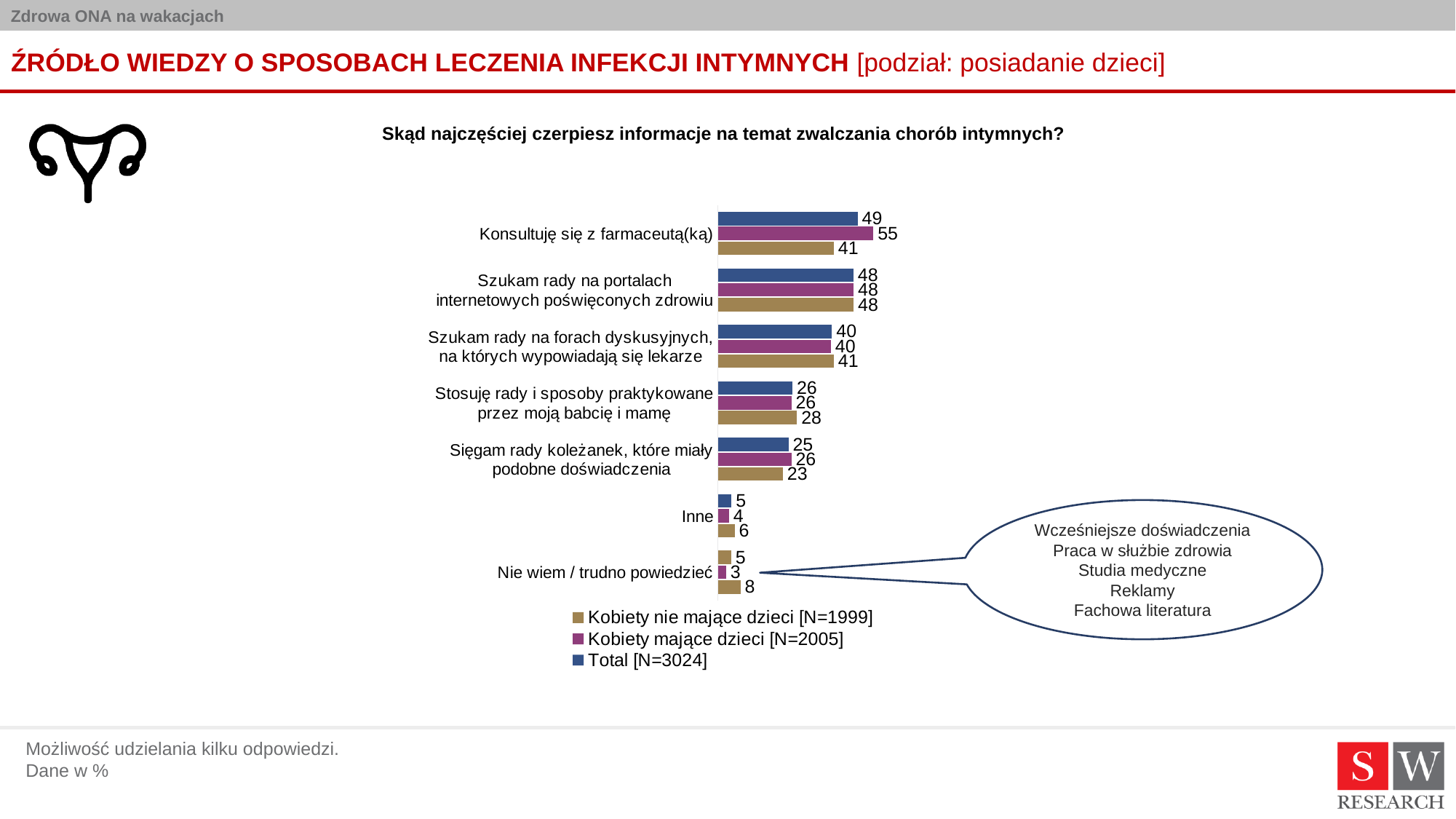
For "Stosuję rady i sposoby praktykowane przez moją babcię i mamę", which series has the larger value: "Kobiety nie mające dzieci [N=1999]" or "Total [N=3024]"? Kobiety nie mające dzieci [N=1999] Which category has the highest value in the "Kobiety mające dzieci [N=2005]" series? Konsultuję się z farmaceutą(ką) What is the difference between the "Kobiety mające dzieci [N=2005]" and "Kobiety nie mające dzieci [N=1999]" values for "Konsultuję się z farmaceutą(ką)"? 14 What is the value for "Nie wiem / trudno powiedzieć" in the "Kobiety nie mające dzieci [N=1999]" series? 8 How many series does the legend list? 3 How many categories are shown on the chart? 7 Which category has the lowest value in the "Kobiety mające dzieci [N=2005]" series? Nie wiem / trudno powiedzieć Which series is shown in blue in the legend? Total [N=3024] What kind of chart is shown on the slide? bar chart What is the value for "Konsultuję się z farmaceutą(ką)" in the "Kobiety mające dzieci [N=2005]" series? 55 What is the value for "Szukam rady na portalach internetowych poświęconych zdrowiu" in the "Kobiety nie mające dzieci [N=1999]" series? 48 What is the value for "Sięgam rady koleżanek, które miały podobne doświadczenia" in the "Total [N=3024]" series? 25